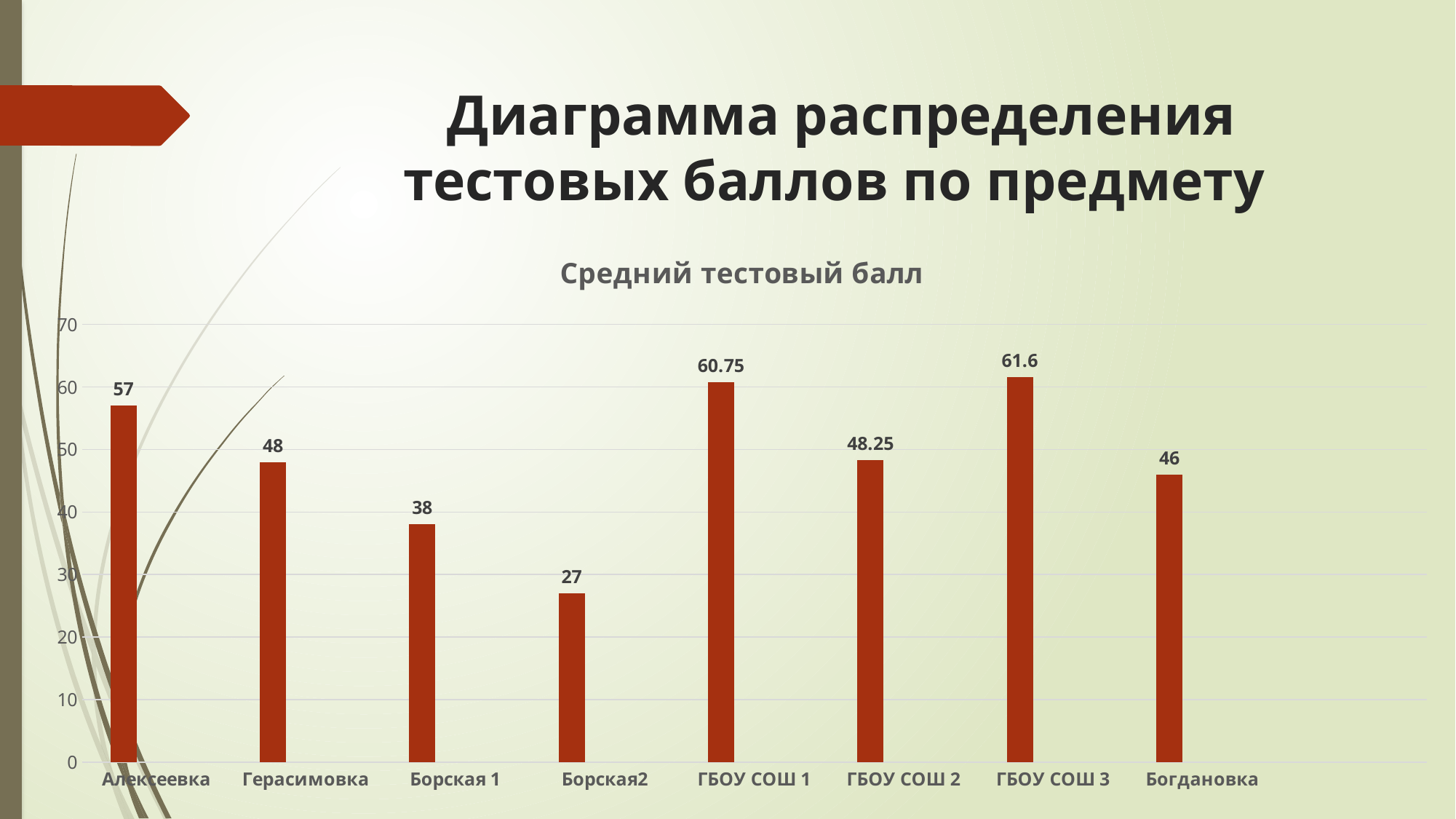
Is the value for ГБОУ СОШ 2 greater or less than 40? greater Which school has the lowest average test score? Борская2 What is the average test score for Герасимовка? 48 What is the average test score for ГБОУ СОШ 1? 60.75 Which school has the highest average test score? ГБОУ СОШ 3 Which is larger, the value for Алексеевка or the value for Герасимовка? Алексеевка What kind of chart is shown on the slide? bar chart How many schools are shown on the chart? 8 What is the difference between the values for ГБОУ СОШ 3 and ГБОУ СОШ 2? 13.35 What is the difference between the values for Алексеевка and Борская 1? 19 What is the value shown for Богдановка? 46 What is the title of the chart? Средний тестовый балл